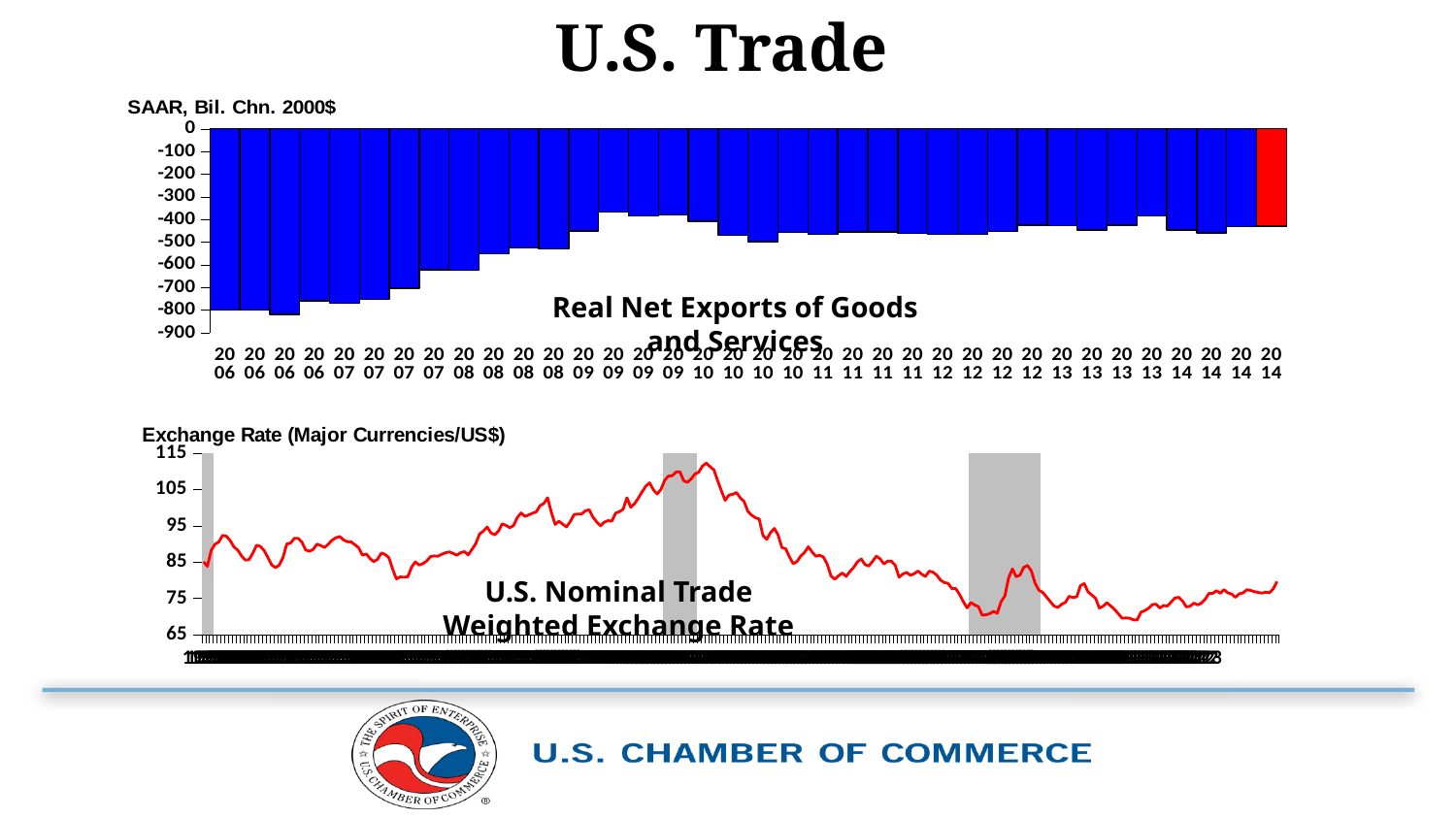
In the top chart, Real Net Exports of Goods and Services, how many bars are plotted? 36 What kind of chart is the bottom chart, U.S. Nominal Trade Weighted Exchange Rate? line chart In the top chart, Real Net Exports of Goods and Services, is the value for the first 2006 bar greater or less than -700? less In the top chart, Real Net Exports of Goods and Services, do the bar values rise or fall from 2006 to 2009? rise In the top chart, Real Net Exports of Goods and Services, what is the lowest value shown on the y axis? -900 In the top chart, Real Net Exports of Goods and Services, are the plotted values positive or negative? negative In the top chart, Real Net Exports of Goods and Services, what colour is the final bar? red In the bottom chart, U.S. Nominal Trade Weighted Exchange Rate, is the highest point of the line greater or less than 105? greater In the top chart, Real Net Exports of Goods and Services, is the value for the last 2014 bar (the red bar) greater or less than -500? greater What kind of chart is the top chart, Real Net Exports of Goods and Services? bar chart